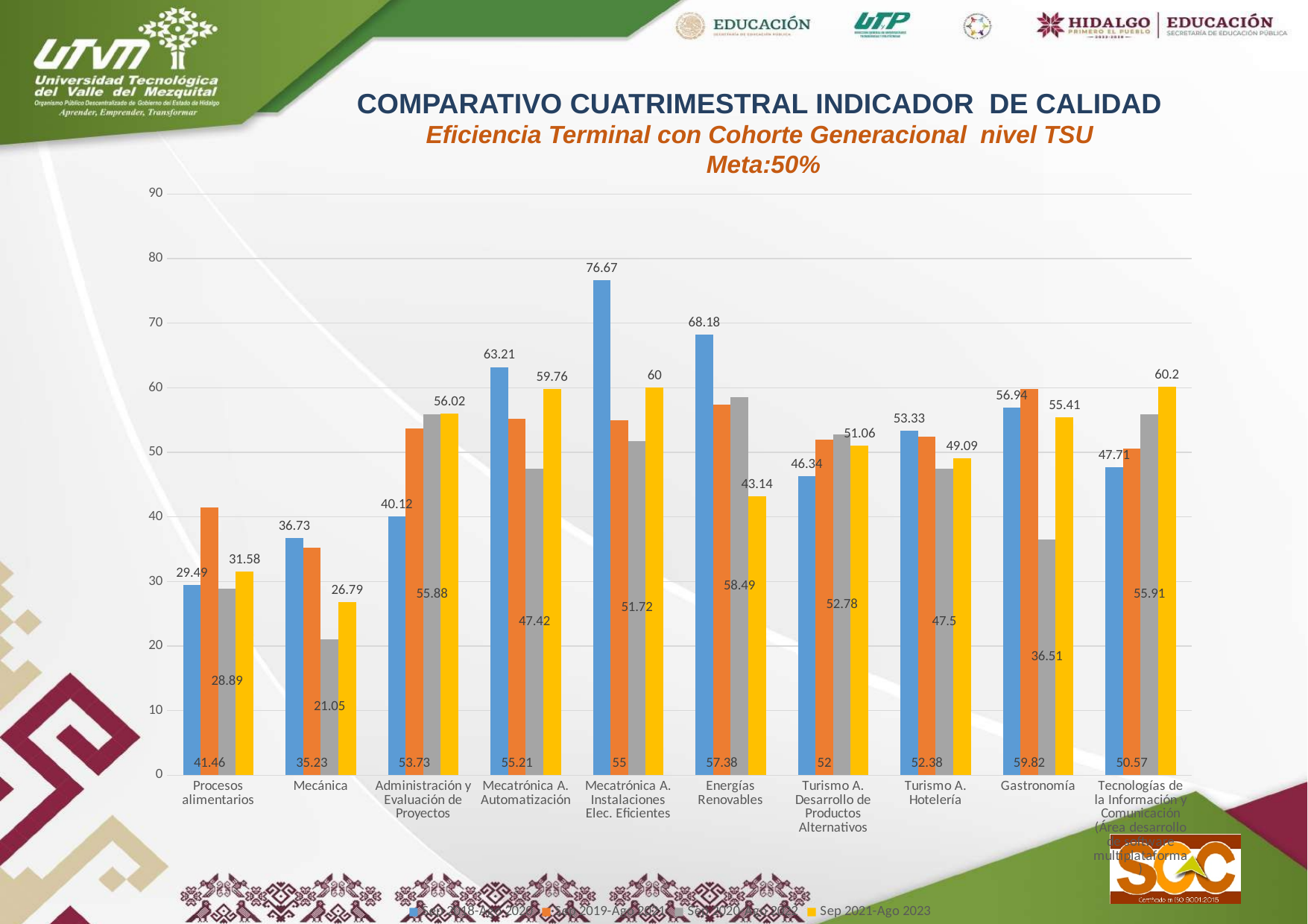
For Gastronomía, which is larger: the orange bar or the gray bar? the orange bar Which category has the lowest gray bar? Mecánica For Mecánica, what is the difference between the blue bar (36.73) and the gray bar (21.05)? 15.68 What kind of chart is shown on the slide? bar chart Is the yellow bar for Mecánica greater or less than 30? less For Energías Renovables, what is the difference between the blue bar (68.18) and the yellow bar (43.14)? 25.04 How many categories (programs) are shown on the x axis? 10 How many series does the legend list? 4 What is the value of the orange bar for Turismo A. Desarrollo de Productos Alternativos? 52 What is the value of the blue bar for Mecatrónica A. Instalaciones Elec. Eficientes? 76.67 Which category has the highest blue bar? Mecatrónica A. Instalaciones Elec. Eficientes What is the Sep 2021-Ago 2023 (yellow) value for Tecnologías de la Información y Comunicación? 60.2